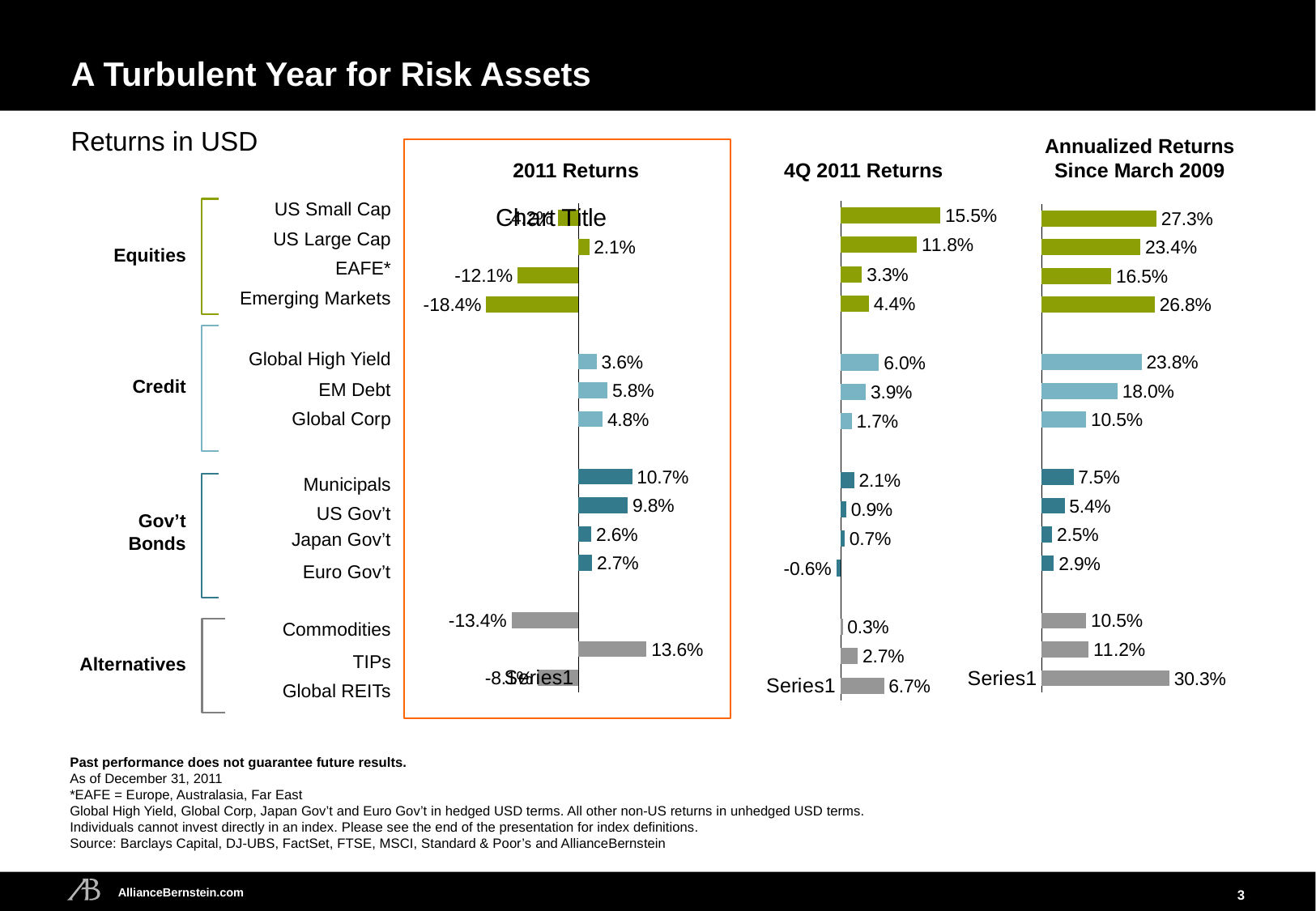
In the Annualized Returns Since March 2009 chart, which is larger, US Large Cap or Global High Yield? Global High Yield In the 2011 Returns chart, what is the value for Municipals? 10.7% In the 4Q 2011 Returns chart, what is the value for Global High Yield? 6.0% What kind of chart is the Annualized Returns Since March 2009 chart? Bar chart In the 2011 Returns chart, what is the value for Emerging Markets? -18.4% In the 4Q 2011 Returns chart, which category has the highest value? US Small Cap In the 4Q 2011 Returns chart, what is the difference between US Small Cap and US Large Cap? 3.7 percentage points In the 2011 Returns chart, which category has the lowest value? Emerging Markets In the 4Q 2011 Returns chart, which category has the lowest value? Euro Gov't How many categories are plotted in the 4Q 2011 Returns chart? 14 In the Annualized Returns Since March 2009 chart, what is the value for EM Debt? 18.0% In the Annualized Returns Since March 2009 chart, which category has the highest value? Global REITs